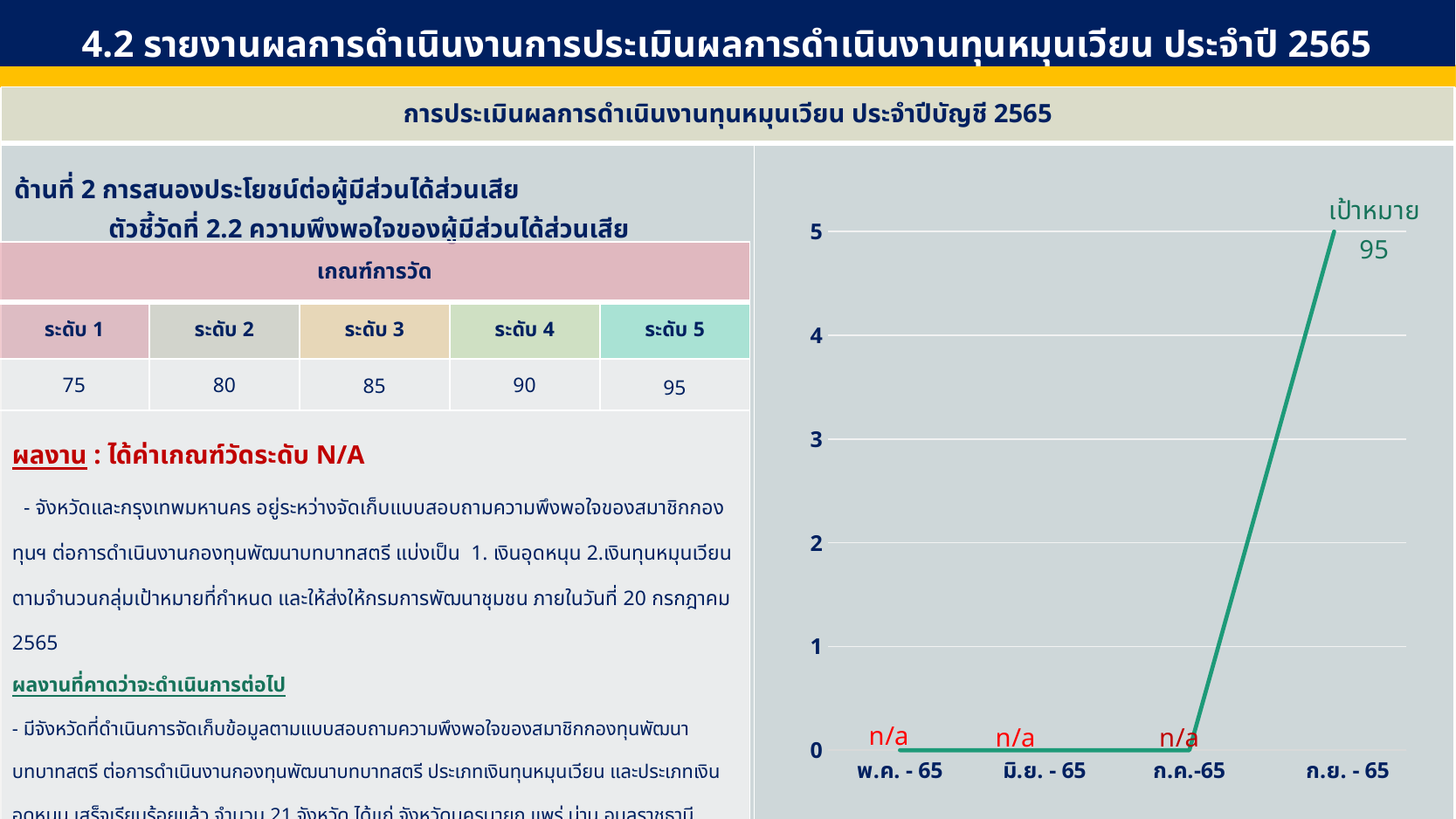
How many categories are shown on the x axis of the chart? 4 Is the value for ก.ย. - 65 greater or less than 3 on the axis? greater What is the highest tick value shown on the y axis of the chart? 5 What number is printed next to the point for ก.ย. - 65 in the chart? 95 What data label is shown for พ.ค. - 65 in the chart? n/a Which axis level does the line reach at ก.ย. - 65? 5 What Thai word is written above the point for ก.ย. - 65 in the chart? เป้าหมาย What type of chart is shown on the right side of the slide? line chart What data label is shown for มิ.ย. - 65 in the chart? n/a Which category has the highest point on the line? ก.ย. - 65 What data label is shown for ก.ค.-65 in the chart? n/a Does the line rise or fall between ก.ค.-65 and ก.ย. - 65? rise